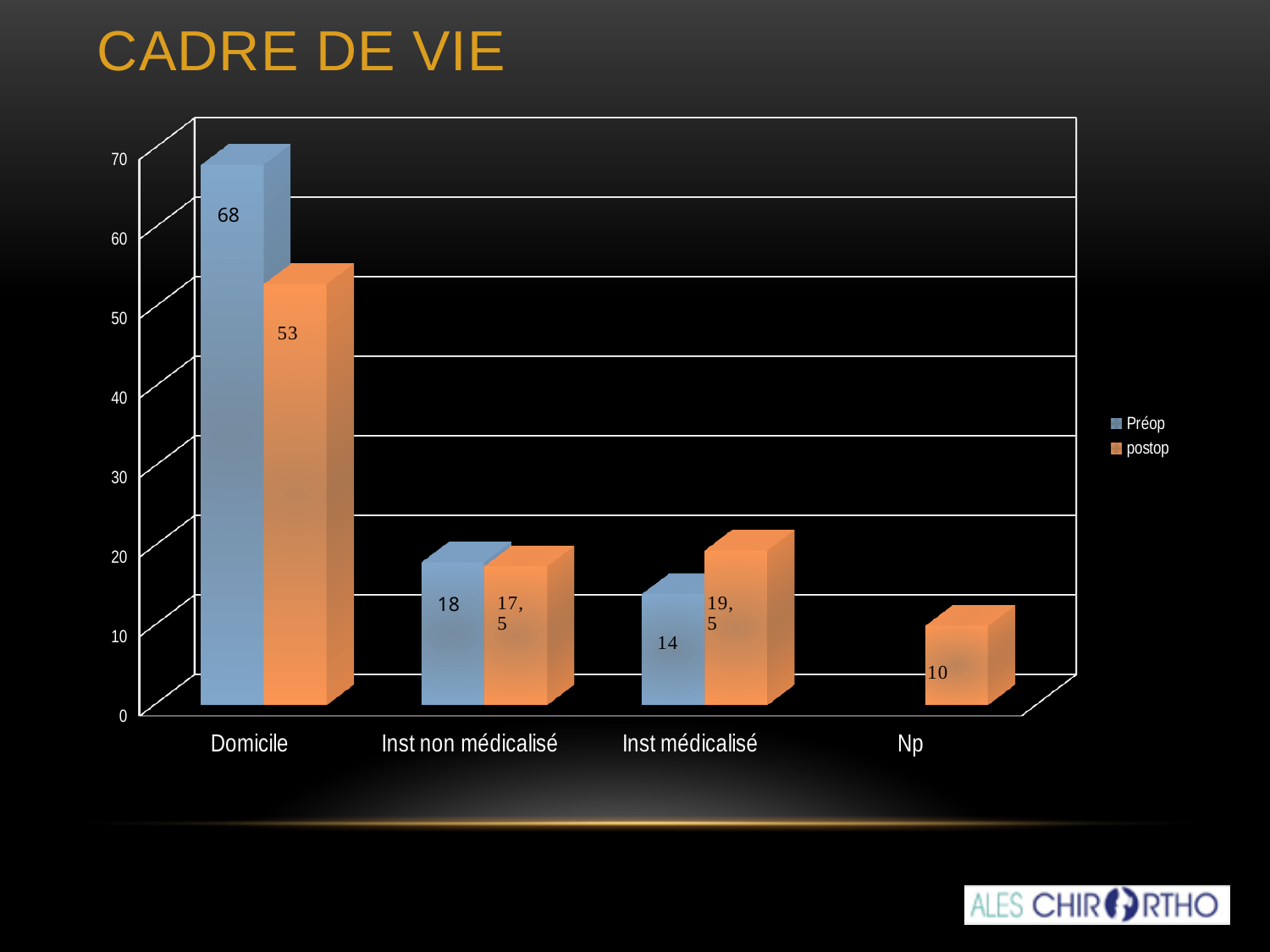
What is the difference between the Préop and postop values for Domicile? 15 What kind of chart is shown on the slide? bar chart What is the postop value for Np? 10 What is the title of the slide? CADRE DE VIE How many series does the legend list? 2 What is the Préop value for Domicile? 68 How many categories are shown on the x axis? 4 What is the postop value for Inst médicalisé? 19,5 Which category has the highest Préop value? Domicile What is the postop value for Domicile? 53 Which category has the lowest postop value? Np For Inst médicalisé, which is larger: the Préop value or the postop value? postop